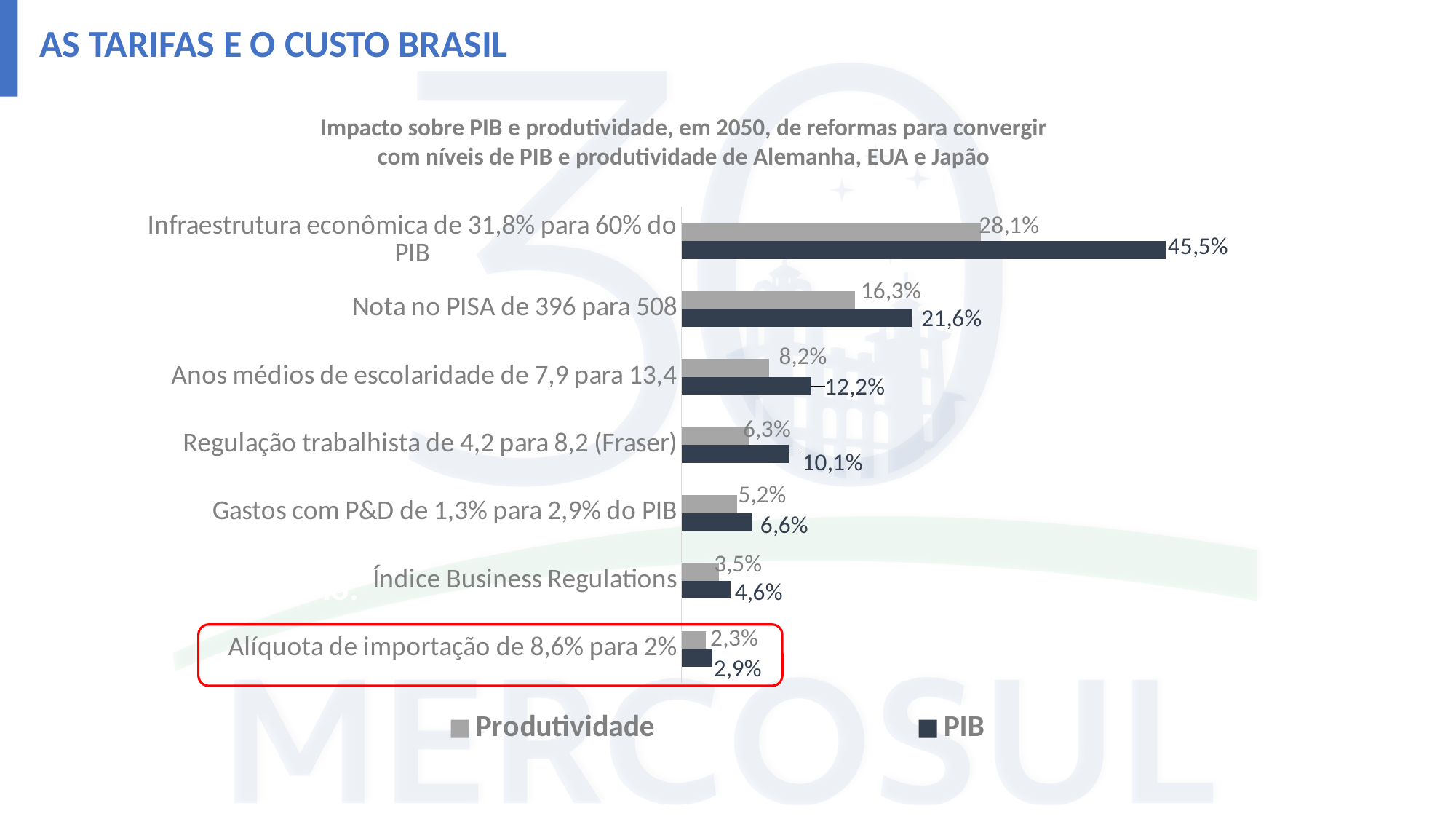
Which is larger for "Regulação trabalhista de 4,2 para 8,2 (Fraser)": the PIB value or the Produtividade value? PIB Which category is highlighted with a red outline on the chart? Alíquota de importação de 8,6% para 2% Which category has the highest PIB value? Infraestrutura econômica de 31,8% para 60% do PIB What kind of chart is shown on the slide? Bar chart What is the Produtividade value for "Gastos com P&D de 1,3% para 2,9% do PIB"? 5,2% What is the Produtividade value for "Nota no PISA de 396 para 508"? 16,3% How many series does the legend list? 2 How many categories are shown in the chart? 7 What is the PIB value for "Infraestrutura econômica de 31,8% para 60% do PIB"? 45,5% What is the PIB value for "Alíquota de importação de 8,6% para 2%"? 2,9% Which category has the lowest Produtividade value? Alíquota de importação de 8,6% para 2% What is the difference between the PIB and Produtividade values for "Anos médios de escolaridade de 7,9 para 13,4"? 4,0%